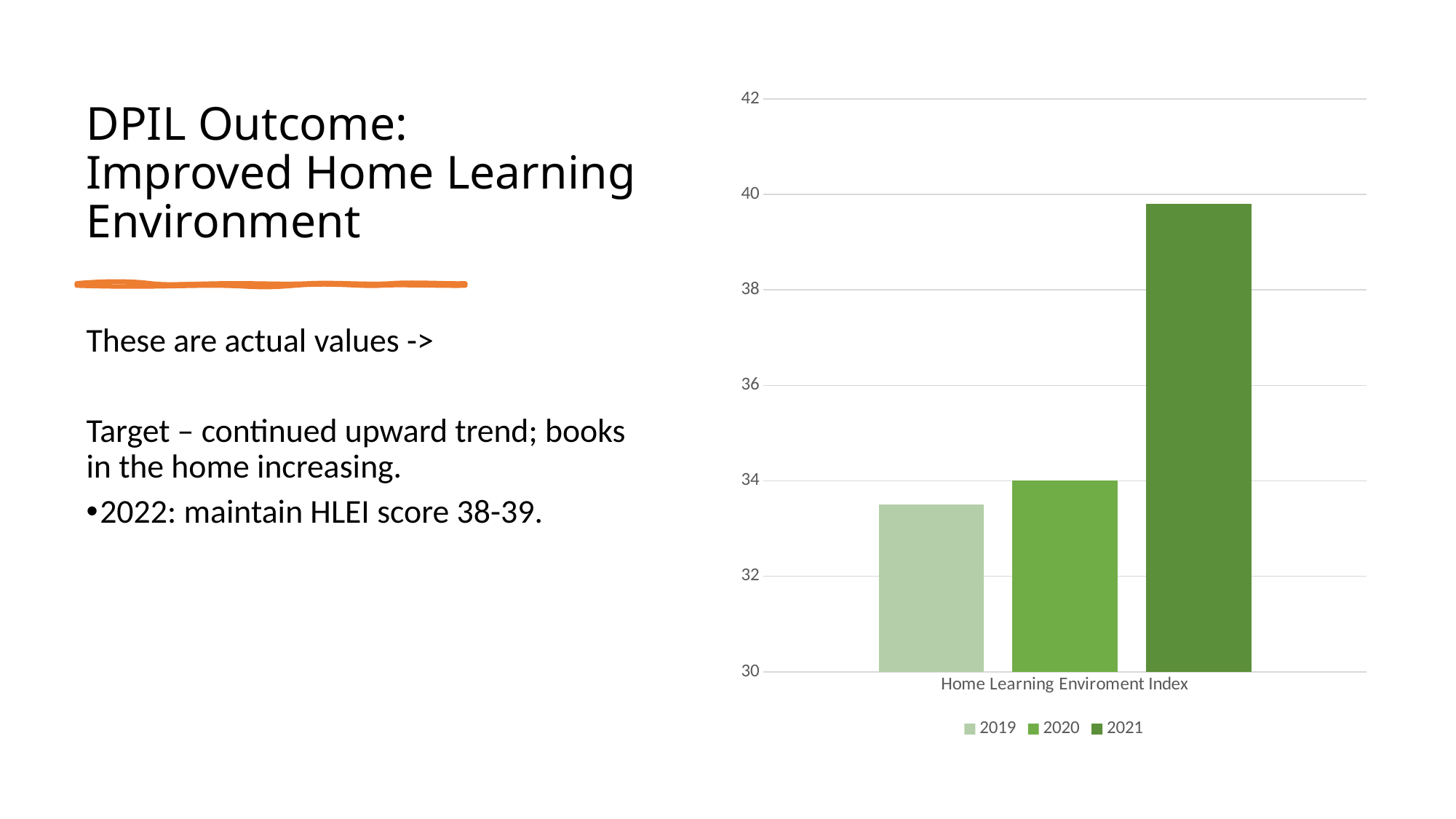
Is the value for 2019 greater or less than 34? less Which year has the highest Home Learning Enviroment Index value? 2021 Do the Home Learning Enviroment Index values rise or fall from 2019 to 2021? rise What are the legend entries of the chart? 2019, 2020, 2021 What kind of chart is shown on the slide? bar chart Which is larger, the value for 2021 or the value for 2020? 2021 Which year has the lowest Home Learning Enviroment Index value? 2019 Is the value for 2019 greater or less than 32? greater How many series does the chart legend list? 3 Is the value for 2021 greater or less than 38? greater What is the category label shown on the x axis of the chart? Home Learning Enviroment Index How many categories are shown on the x axis of the chart? 1